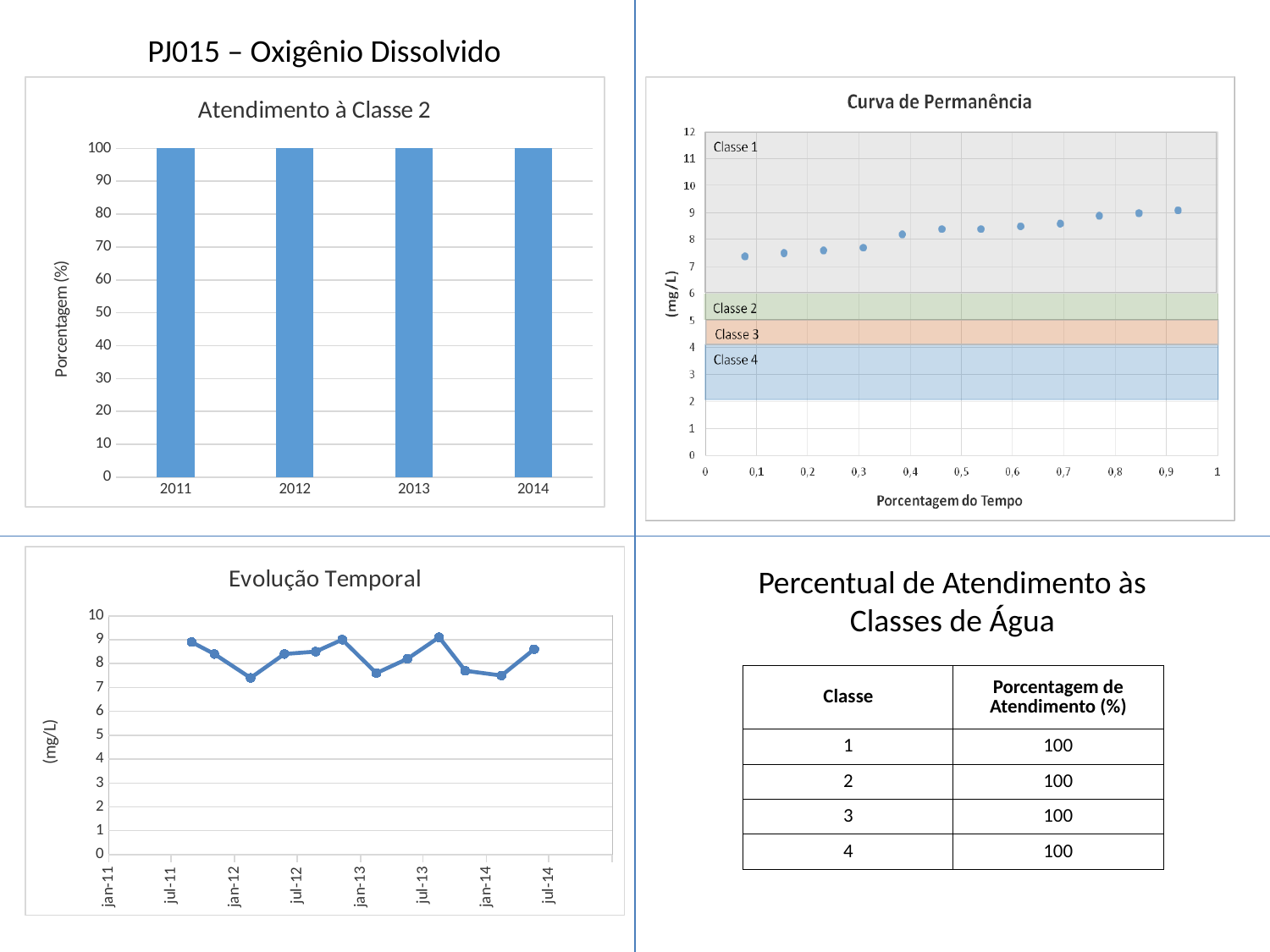
In the 'Curva de Permanência' chart, is the value of the first point (near 0,1) greater or less than 8? less In the 'Evolução Temporal' chart, is the lowest plotted value greater or less than 7? greater In the 'Curva de Permanência' chart, do the values rise or fall as the percentage of time increases? rise What kind of chart is 'Evolução Temporal'? line chart How many years are shown in the 'Atendimento à Classe 2' chart? 4 What kind of chart is 'Atendimento à Classe 2'? bar chart In the 'Atendimento à Classe 2' chart, what is the value for 2014? 100 What is the x-axis label of the 'Curva de Permanência' chart? Porcentagem do Tempo In the 'Atendimento à Classe 2' chart, do the values rise, fall or stay the same from 2011 to 2014? stay the same What is the y-axis label of the 'Atendimento à Classe 2' chart? Porcentagem (%) In the 'Atendimento à Classe 2' chart, what is the value for 2011? 100 How many data points are plotted in the 'Curva de Permanência' chart? 12